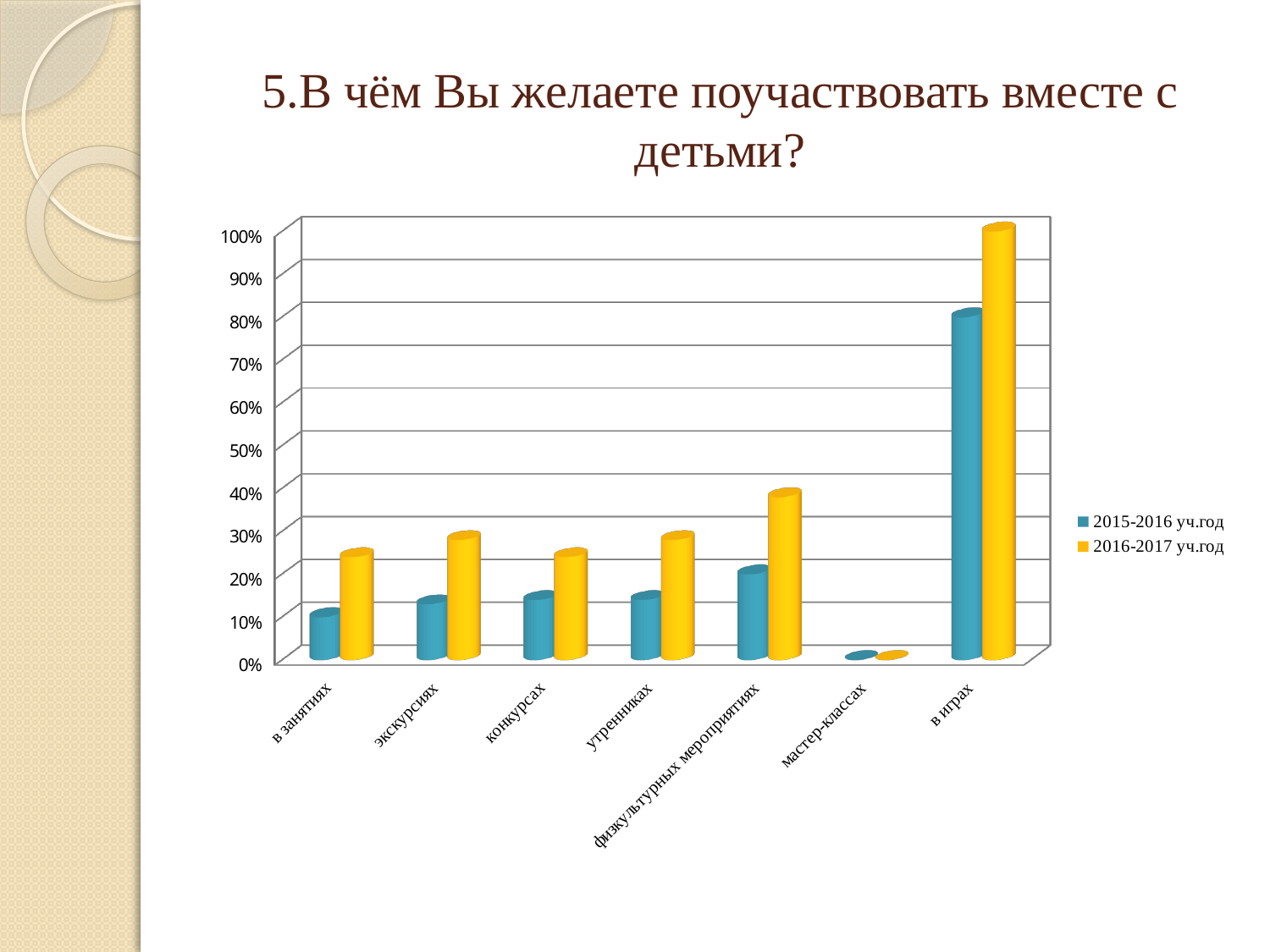
Which category has the lowest value for the 2016-2017 уч.год series? мастер-классах What are the two entries listed in the legend? 2015-2016 уч.год and 2016-2017 уч.год How many categories are shown on the x axis? 7 For the category в играх, which series has the larger value: 2015-2016 уч.год or 2016-2017 уч.год? 2016-2017 уч.год Is the value for физкультурных мероприятиях in the 2016-2017 уч.год series greater or less than 30%? greater What kind of chart is shown on the slide? bar chart Is the value for в играх in the 2015-2016 уч.год series greater or less than 70%? greater How many series does the legend list? 2 In the 2015-2016 уч.год series, which is larger: физкультурных мероприятиях or в занятиях? физкультурных мероприятиях Which category has the highest value for the 2015-2016 уч.год series? в играх Which category has the highest value for the 2016-2017 уч.год series? в играх Is the value for в занятиях in the 2015-2016 уч.год series greater or less than 20%? less